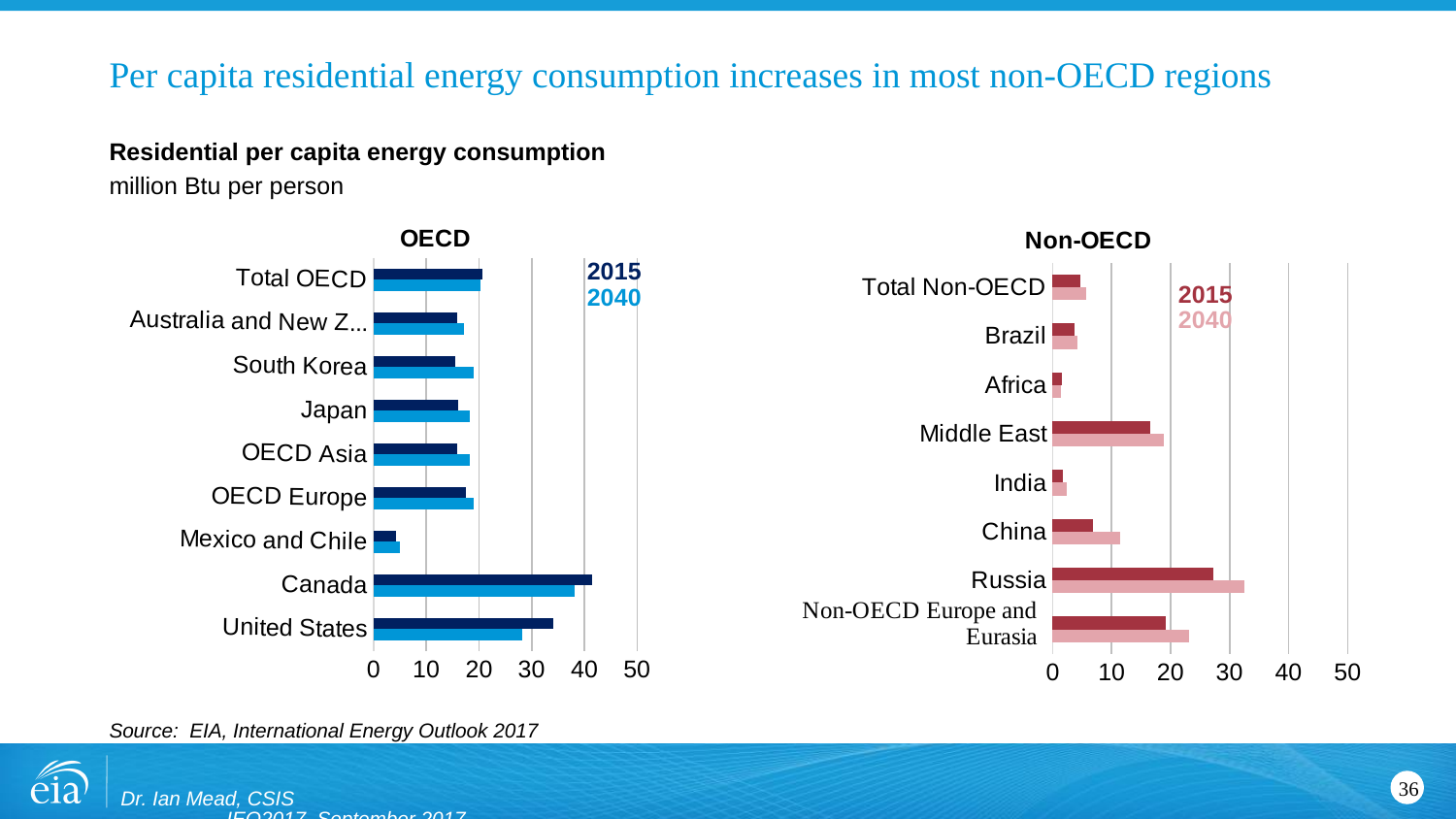
What unit is given for the values on the charts? million Btu per person How many series does the legend of the Non-OECD chart list? 2 On the Non-OECD chart, which is larger for 2040: China or India? China How many categories are shown on the Non-OECD chart? 8 What kind of chart is the OECD chart? bar chart On the Non-OECD chart, which category has the highest 2040 value? Russia How many categories are shown on the OECD chart? 9 On the OECD chart, which is larger for 2015: Canada or United States? Canada On the OECD chart, is the 2015 value for Canada greater or less than 30? greater On the OECD chart, which category has the lowest 2015 value? Mexico and Chile On the OECD chart, which category has the highest 2015 value? Canada On the Non-OECD chart, is the 2015 value for Middle East greater or less than 20? less